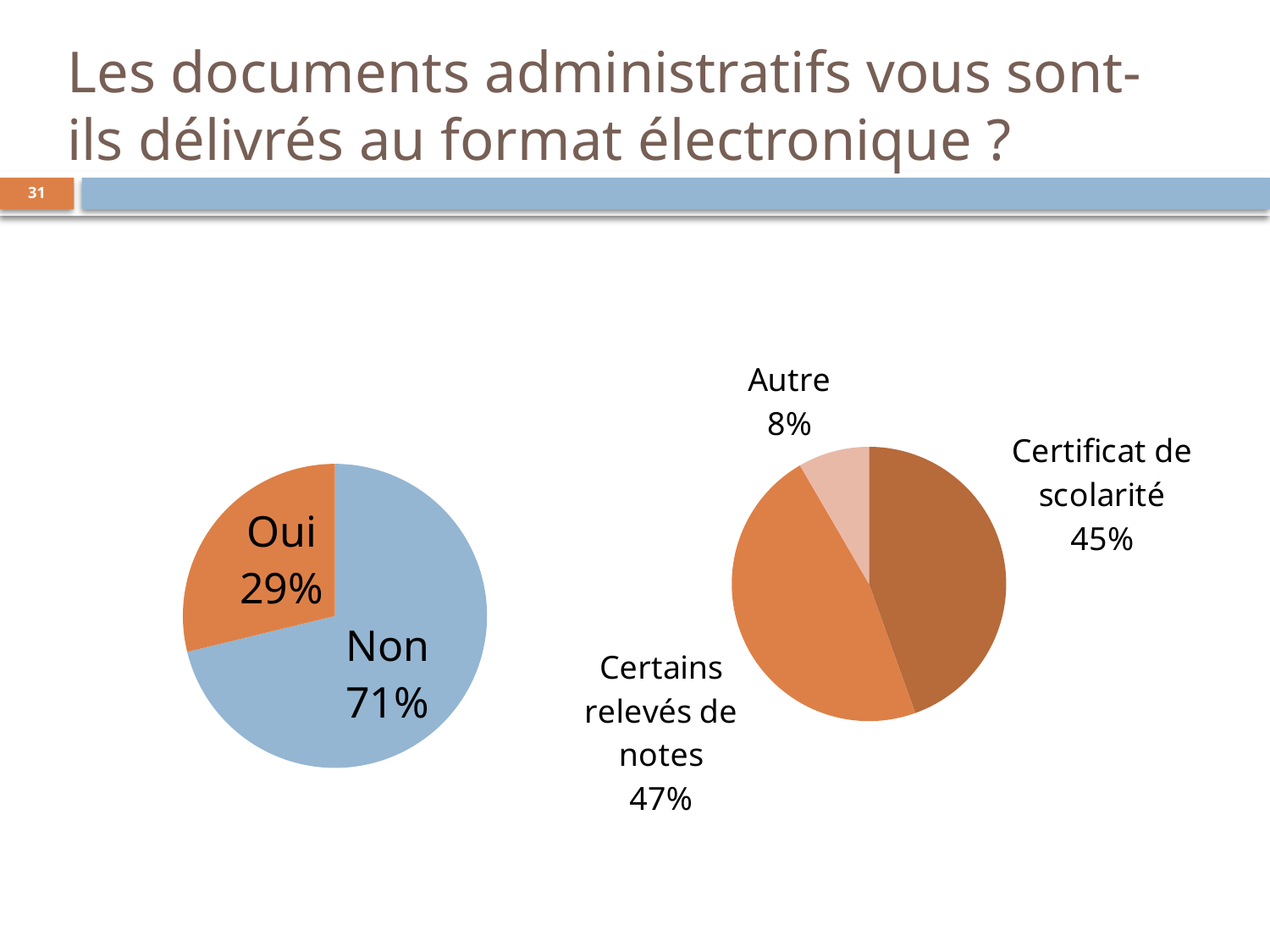
In the left pie chart, what percentage answered "Oui"? 29% In the left pie chart, what is the difference between the "Non" and "Oui" shares? 42% In the right pie chart, how many slices are there? 3 In the right pie chart, what percentage is "Autre"? 8% In the right pie chart, which slice is the smallest? Autre In the right pie chart, what is the difference between "Certains relevés de notes" and "Autre"? 39% In the left pie chart, how many slices are there? 2 In the right pie chart, what percentage is "Certificat de scolarité"? 45% In the left pie chart, which slice is the largest? Non In the right pie chart, what percentage is "Certains relevés de notes"? 47% What kind of chart is the chart on the left? Pie chart In the left pie chart, what percentage answered "Non"? 71%